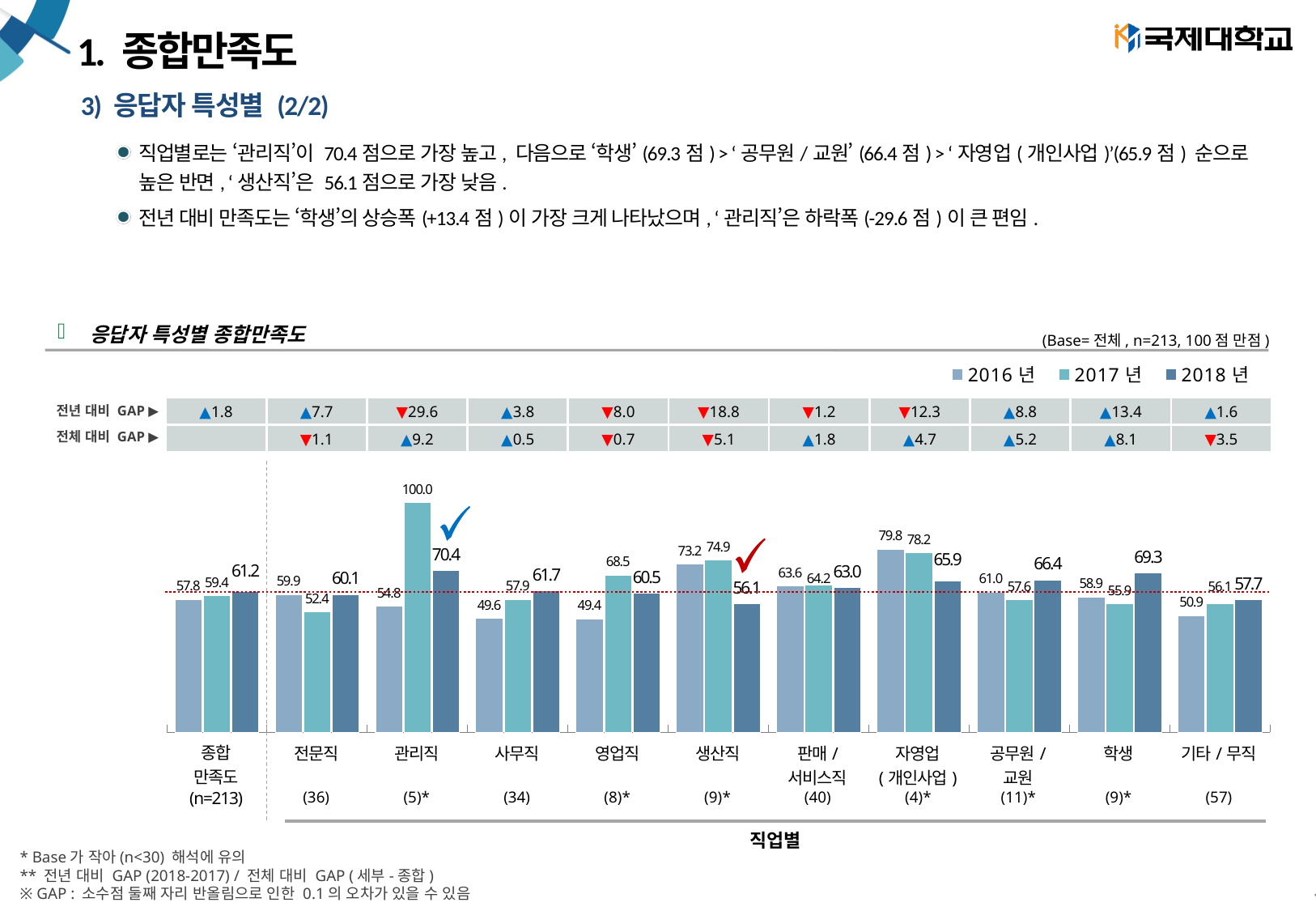
Which category has the highest 2018년 value? 관리직 What is the difference between the 2018년 and 2017년 values for 학생? 13.4 What is the 2017년 value for 관리직? 100.0 Which is larger for 영업직: the 2017년 value or the 2018년 value? 2017년 What is the 2016년 value for 자영업(개인사업)? 79.8 How many series does the legend list? 3 What is the 2018년 value for 종합만족도 (n=213)? 61.2 What is the 전년 대비 GAP shown for 관리직? ▼29.6 What kind of chart is shown on the slide? bar chart How many categories are shown on the x axis? 11 Which category has the lowest 2018년 value? 생산직 What is the 2018년 value for 관리직? 70.4